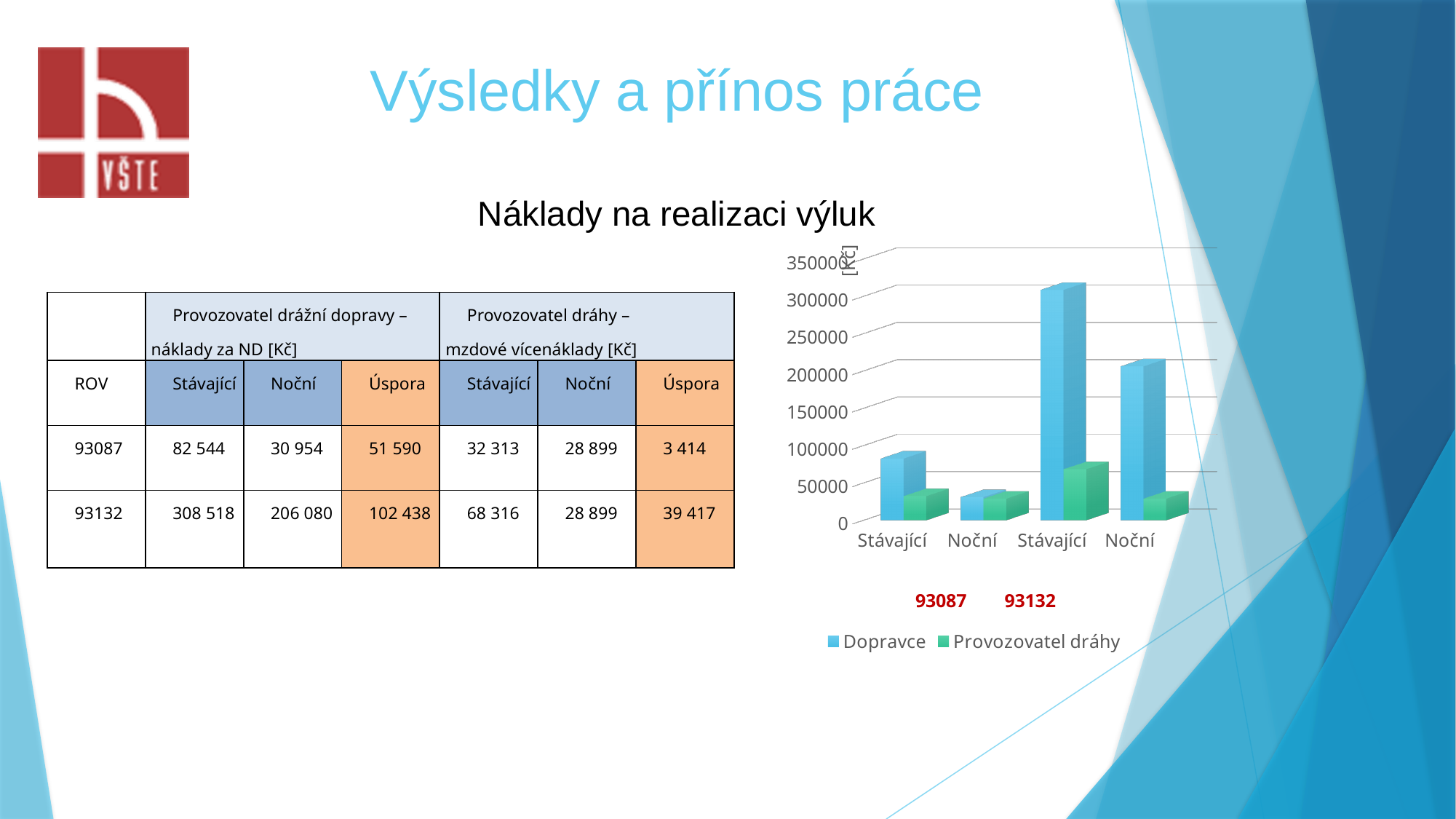
Is the Dopravce value for Stávající under 93087 greater or less than 100000? less Which category has the highest Provozovatel dráhy bar in the chart? Stávající (93132) What kind of chart is shown on the slide? bar chart What unit is shown on the vertical axis of the chart? [Kč] Which category has the lowest Dopravce bar in the chart? Noční (93087) How many categories are shown along the x axis of the chart? 4 How many series does the chart legend list? 2 Is the Dopravce value for Stávající under 93132 greater or less than 250000? greater What is the title shown above the chart? Náklady na realizaci výluk Is the Dopravce value for Noční under 93132 greater or less than 150000? greater For Stávající under 93132, which series has the larger bar, Dopravce or Provozovatel dráhy? Dopravce Which category has the highest Dopravce bar in the chart? Stávající (93132)